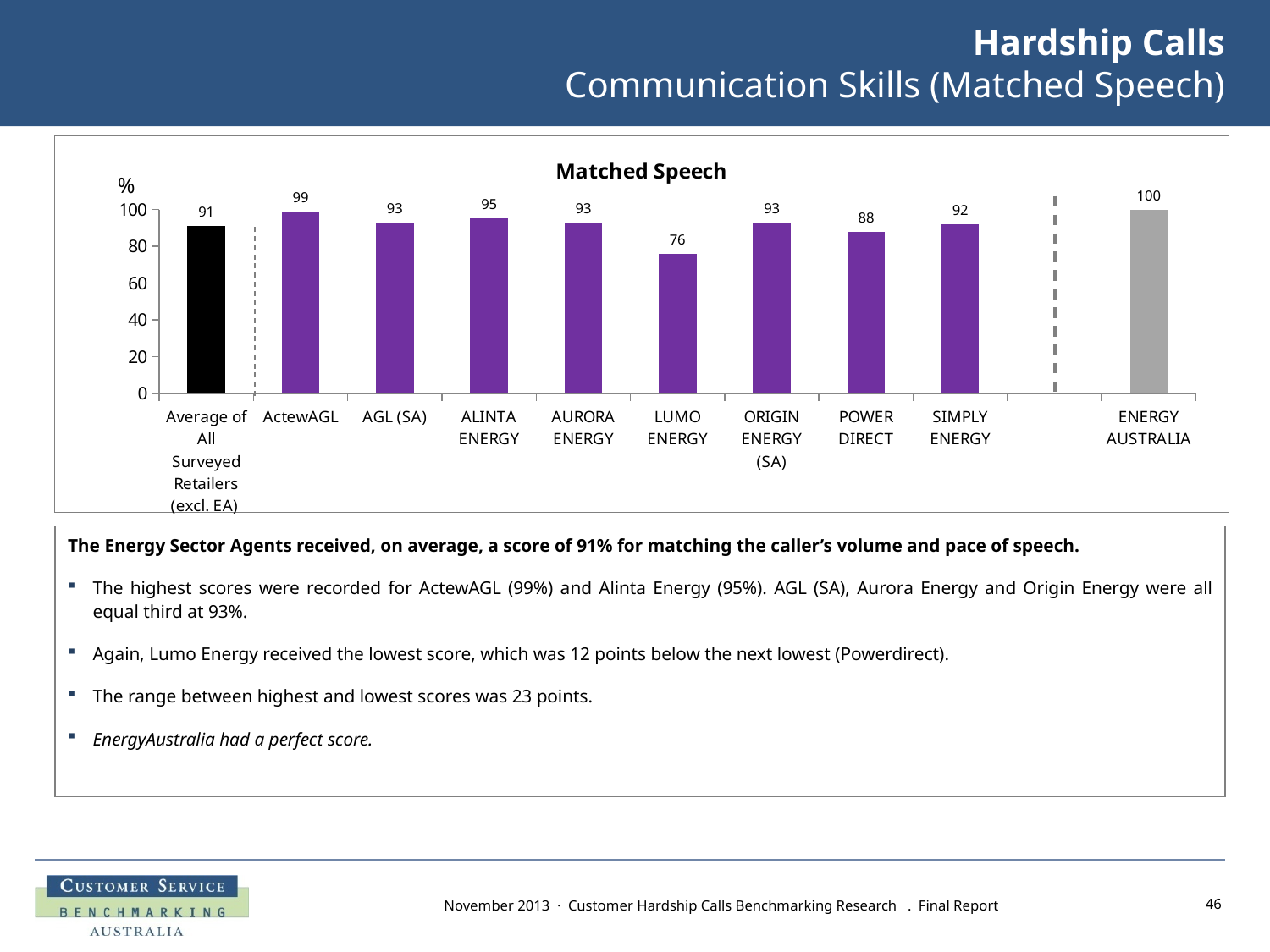
What is the Matched Speech score for ActewAGL? 99 What type of chart is shown on the slide? Bar chart Which has a higher score, ALINTA ENERGY or SIMPLY ENERGY? ALINTA ENERGY What is the value for Average of All Surveyed Retailers (excl. EA)? 91 How many bars are plotted in the chart? 10 What is the title of the chart? Matched Speech Which retailer has the lowest Matched Speech score? LUMO ENERGY What is the value shown for LUMO ENERGY? 76 What is the value shown for ENERGY AUSTRALIA? 100 What is the difference between the scores for ActewAGL and LUMO ENERGY? 23 Excluding ENERGY AUSTRALIA, which retailer has the highest score? ActewAGL What is the difference between the scores for POWER DIRECT and LUMO ENERGY? 12